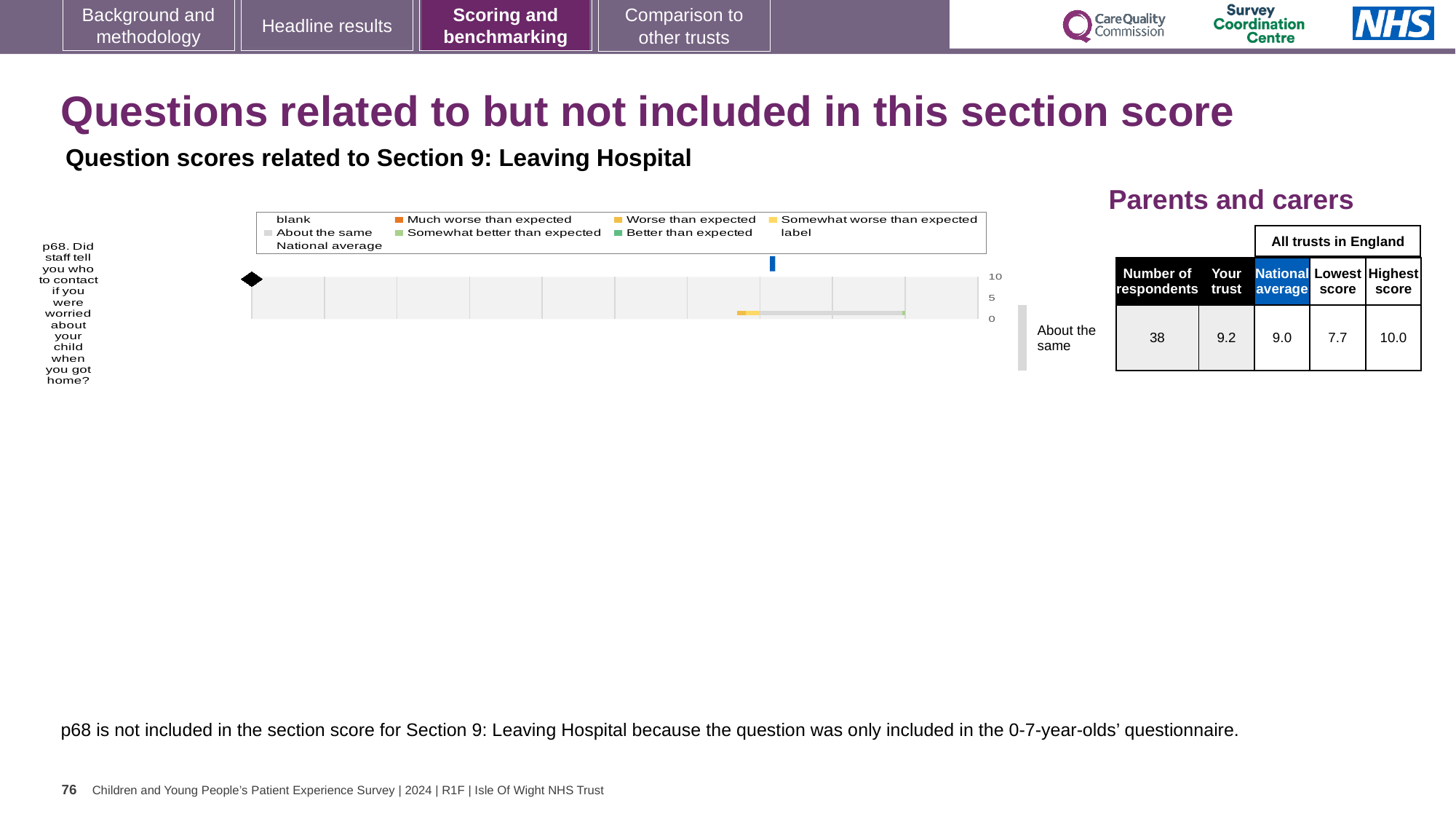
What is the highest value shown on the chart's numeric axis? 10 How many questions (categories) are plotted in the chart? 1 What is the difference between the 'Your trust' score and the national average for p68? 0.2 What is the highest score among all trusts in England for p68? 10.0 What is the 'Your trust' score for p68? 9.2 Which benchmarking category is the p68 score labelled as on the chart? About the same What kind of chart is used to show the p68 question score? bar chart Which is larger for p68, the 'Your trust' score or the national average? Your trust How many respondents answered p68? 38 What is the national average score for p68? 9.0 What is the lowest score among all trusts in England for p68? 7.7 Is the 'Your trust' score for p68 greater or less than 5 on the chart axis? greater